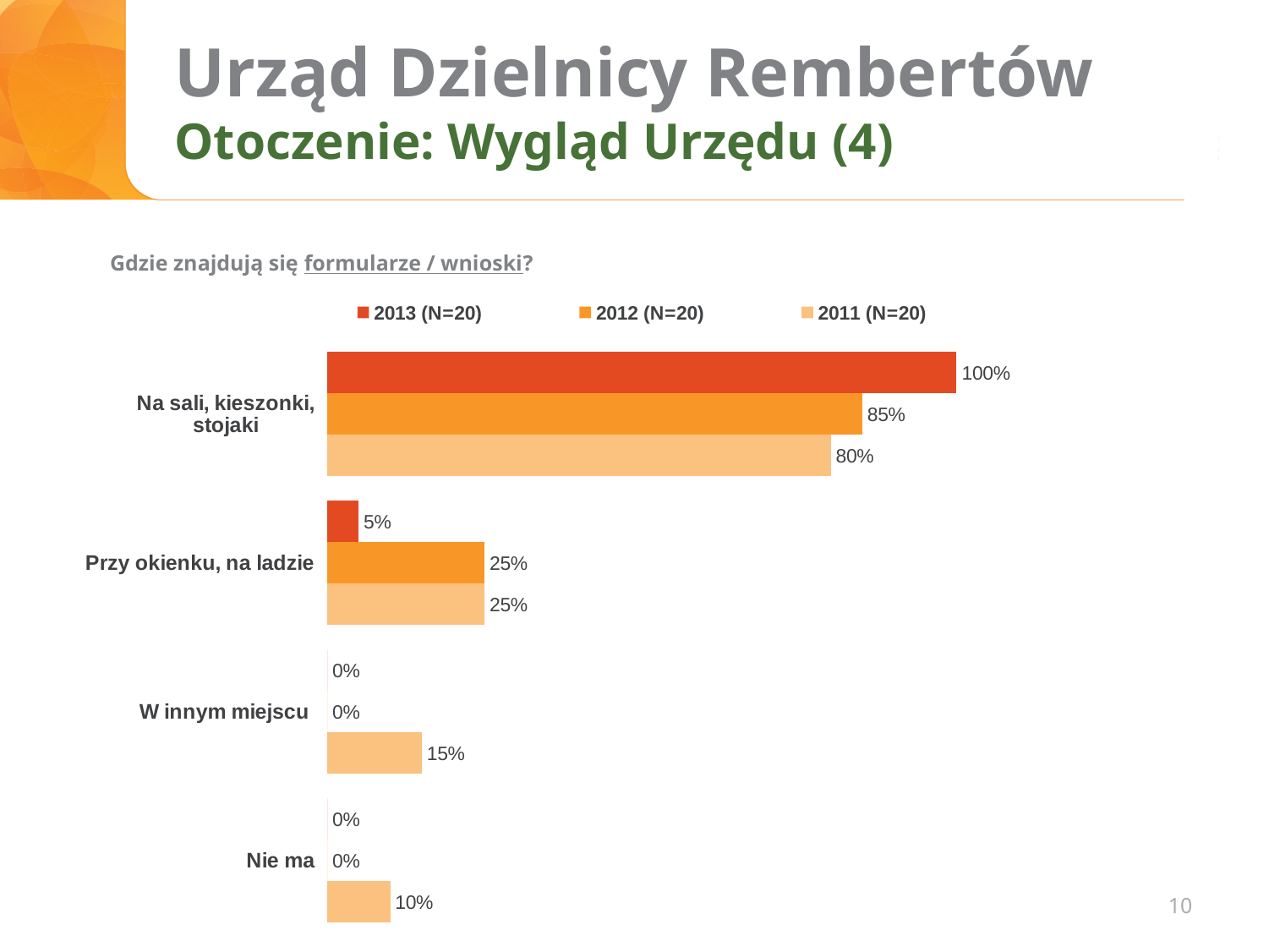
Which is larger for "Przy okienku, na ladzie": the 2013 (N=20) value or the 2012 (N=20) value? 2012 (N=20) What question does the chart answer, as stated above it? Gdzie znajdują się formularze / wnioski? What kind of chart is shown on the slide? Bar chart What is the value for "Nie ma" in the 2011 (N=20) series? 10% What is the value for "W innym miejscu" in the 2011 (N=20) series? 15% Which category has the highest value in the 2013 (N=20) series? Na sali, kieszonki, stojaki What is the value for "Na sali, kieszonki, stojaki" in the 2013 (N=20) series? 100% What is the difference between the 2013 (N=20) and 2011 (N=20) values for "Na sali, kieszonki, stojaki"? 20% How many categories are shown on the chart? 4 What is the value for "Przy okienku, na ladzie" in the 2012 (N=20) series? 25% Which category has the lowest value in the 2011 (N=20) series? Nie ma How many series does the legend list? 3